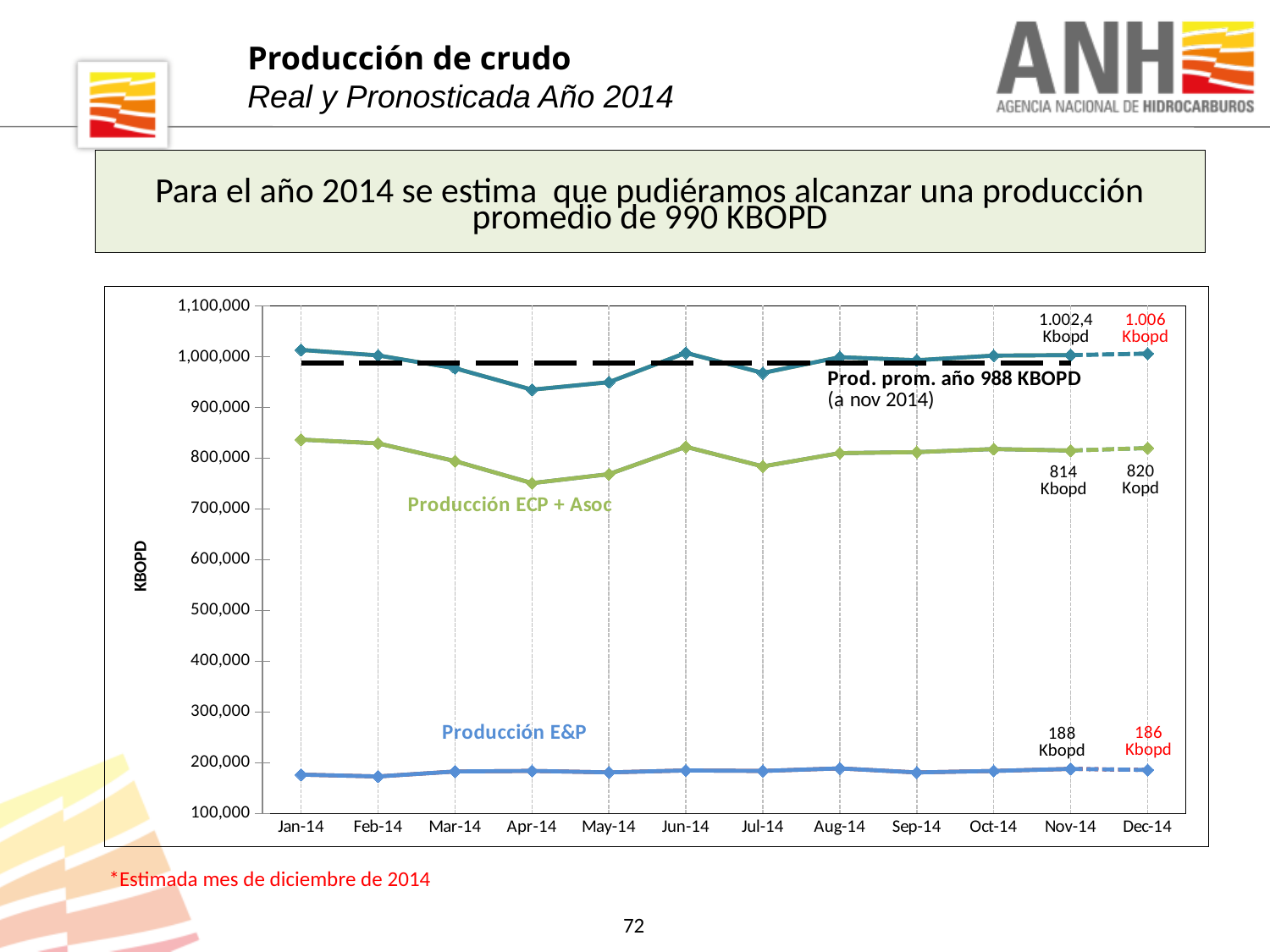
How many months are plotted along the x axis of the chart? 12 In which month does Producción ECP + Asoc reach its lowest value? Apr-14 What average annual production does the dashed line represent? 988 KBOPD Is the value of Producción ECP + Asoc in Apr-14 greater or less than 800,000? less What is the label on the y axis of the chart? KBOPD What is the difference between the Producción E&P values for Nov-14 and Dec-14? 2 Kbopd What is the labelled value of Producción E&P for Nov-14? 188 Kbopd What is the labelled estimated value of Producción E&P for Dec-14? 186 Kbopd Is the value of Producción E&P in Jan-14 greater or less than 200,000? less Is the value of the top (total) line in Apr-14 greater or less than 1,000,000? less What kind of chart is shown on the slide? line chart What is the labelled value of Producción ECP + Asoc for Nov-14? 814 Kbopd